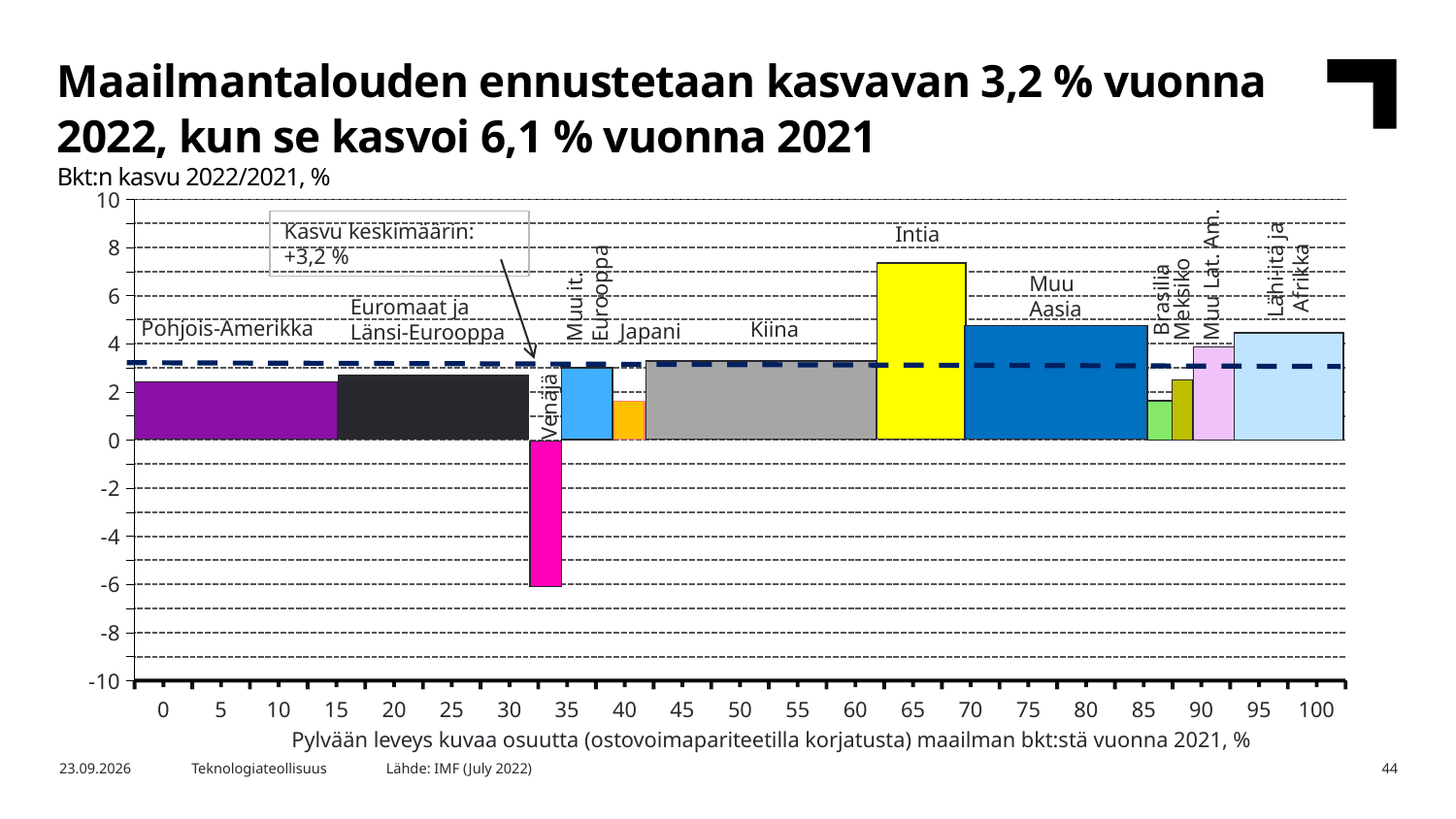
According to the x-axis caption, what does the width of each bar represent? Share of world GDP in 2021 (PPP-adjusted) Is the value for Japani greater or less than 2? less What kind of chart is shown on the slide? Bar chart Which region has the lowest GDP growth in the chart? Venäjä Which has the larger GDP growth, Intia or Kiina? Intia Is the value for Venäjä greater or less than -4? less Is the value for Intia greater or less than 6? greater Which has the larger GDP growth, Venäjä or Japani? Japani How many regions are shown as bars in the chart? 12 What average growth value is printed in the annotation box on the chart? +3,2 % Which region has the highest GDP growth in the chart? Intia